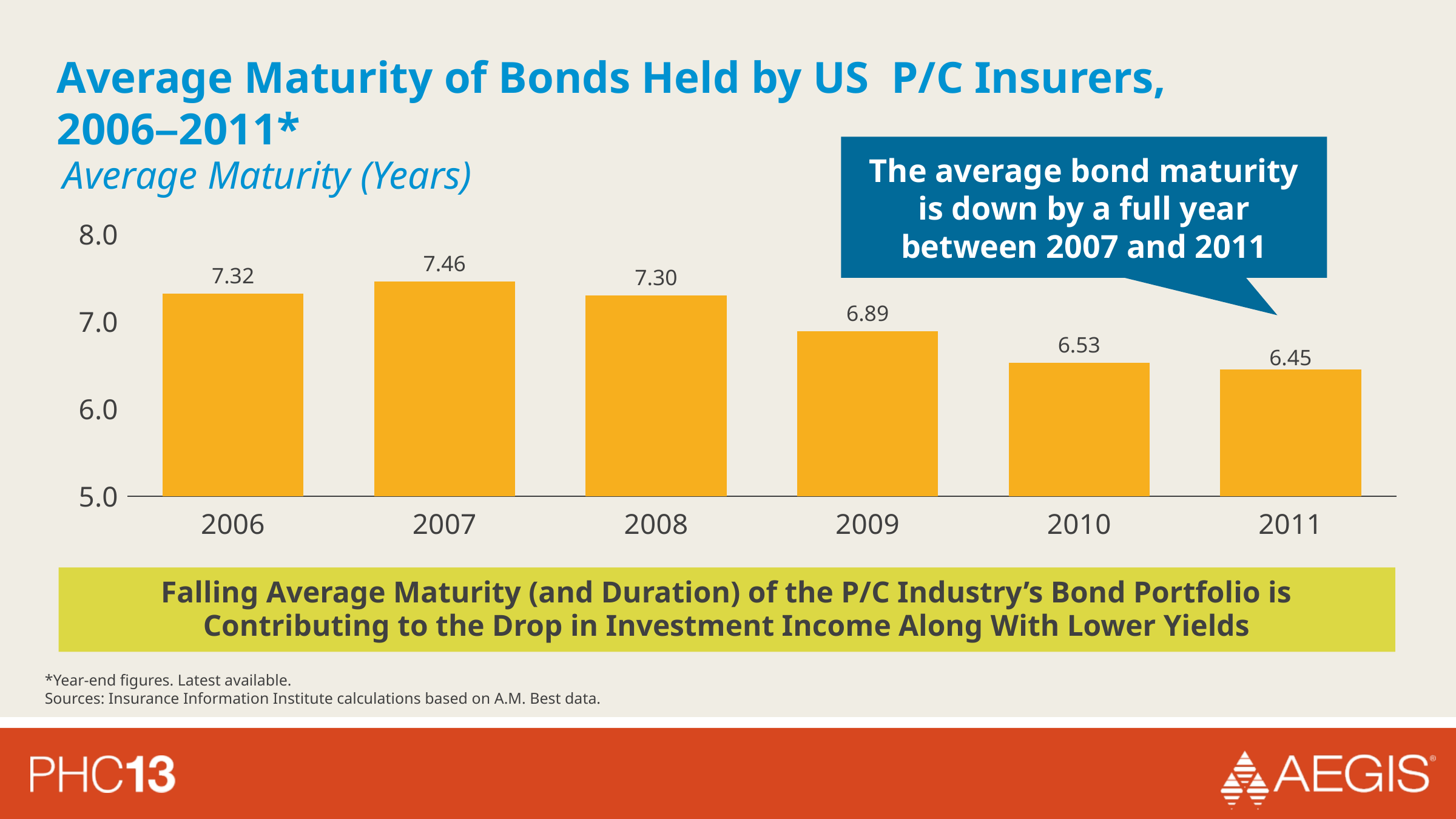
Which year has the highest average bond maturity? 2007 Do the average maturity values rise or fall from 2007 to 2011? fall Which year has the lowest average bond maturity? 2011 Is the value for 2010 greater or less than 7.0? less What is the average maturity value shown for 2009? 6.89 What is the average maturity of bonds held by US P/C insurers in 2006? 7.32 What kind of chart is used to show the average maturity of bonds? bar chart How many years are shown on the x axis of the chart? 6 What is the difference between the average maturity in 2008 and in 2009? 0.41 What is the average maturity value shown for 2011? 6.45 Which year has a larger average maturity, 2006 or 2008? 2006 What is the difference between the average maturity in 2007 and in 2011? 1.01